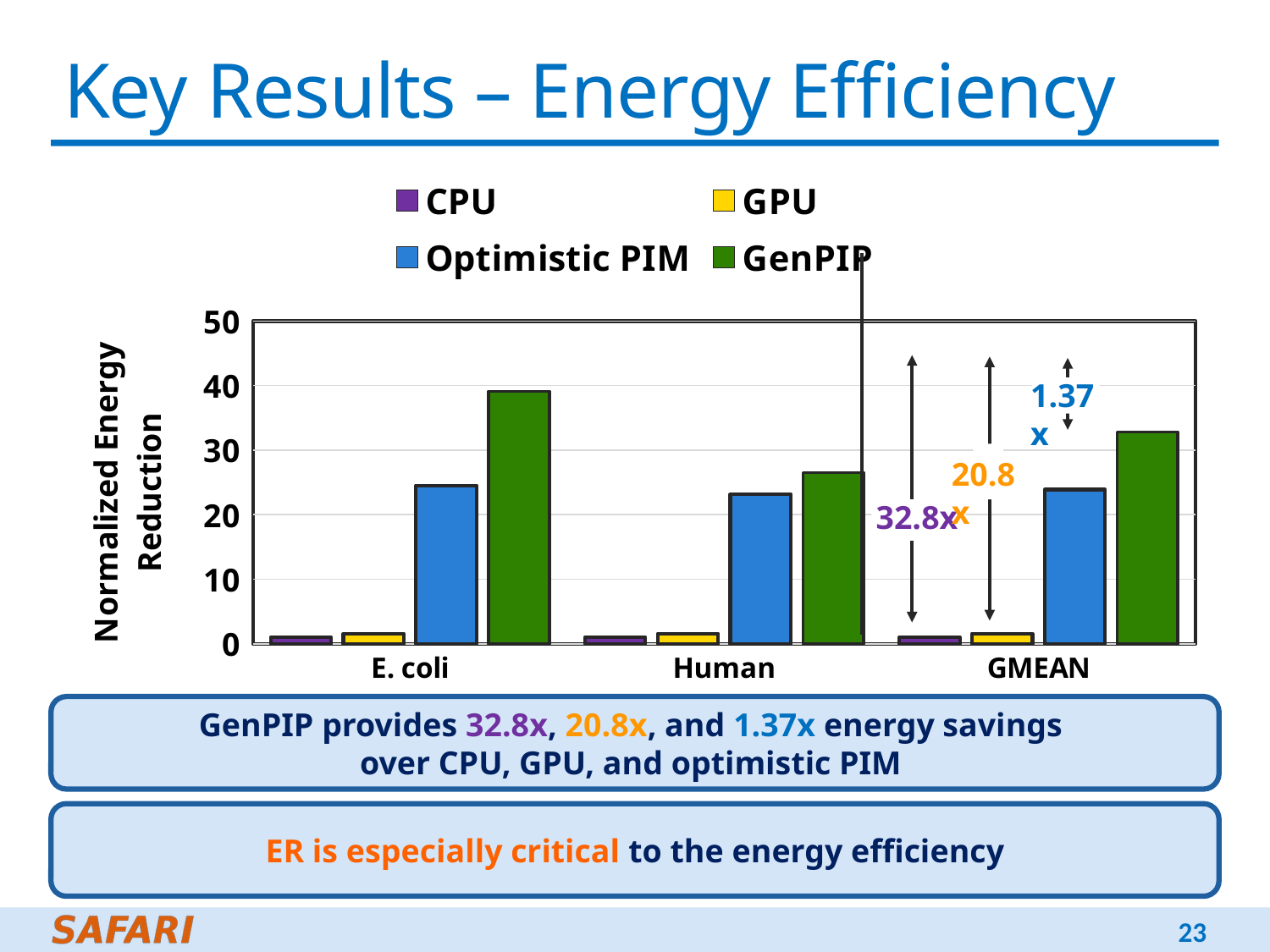
Is the GenPIP value for Human greater or less than 30? less In which category is the GenPIP bar the tallest? E. coli Is the Optimistic PIM value for GMEAN greater or less than 20? greater What kind of chart is shown on the slide? bar chart Is the GenPIP value for E. coli greater or less than 30? greater How many categories are shown on the x axis of the chart? 3 Which series has the highest bar in the E. coli category? GenPIP What is the title of the chart's y axis? Normalized Energy Reduction How many series does the chart's legend list? 4 Which series has the highest bar in the GMEAN category? GenPIP In the Human category, which is larger: the GenPIP bar or the Optimistic PIM bar? GenPIP